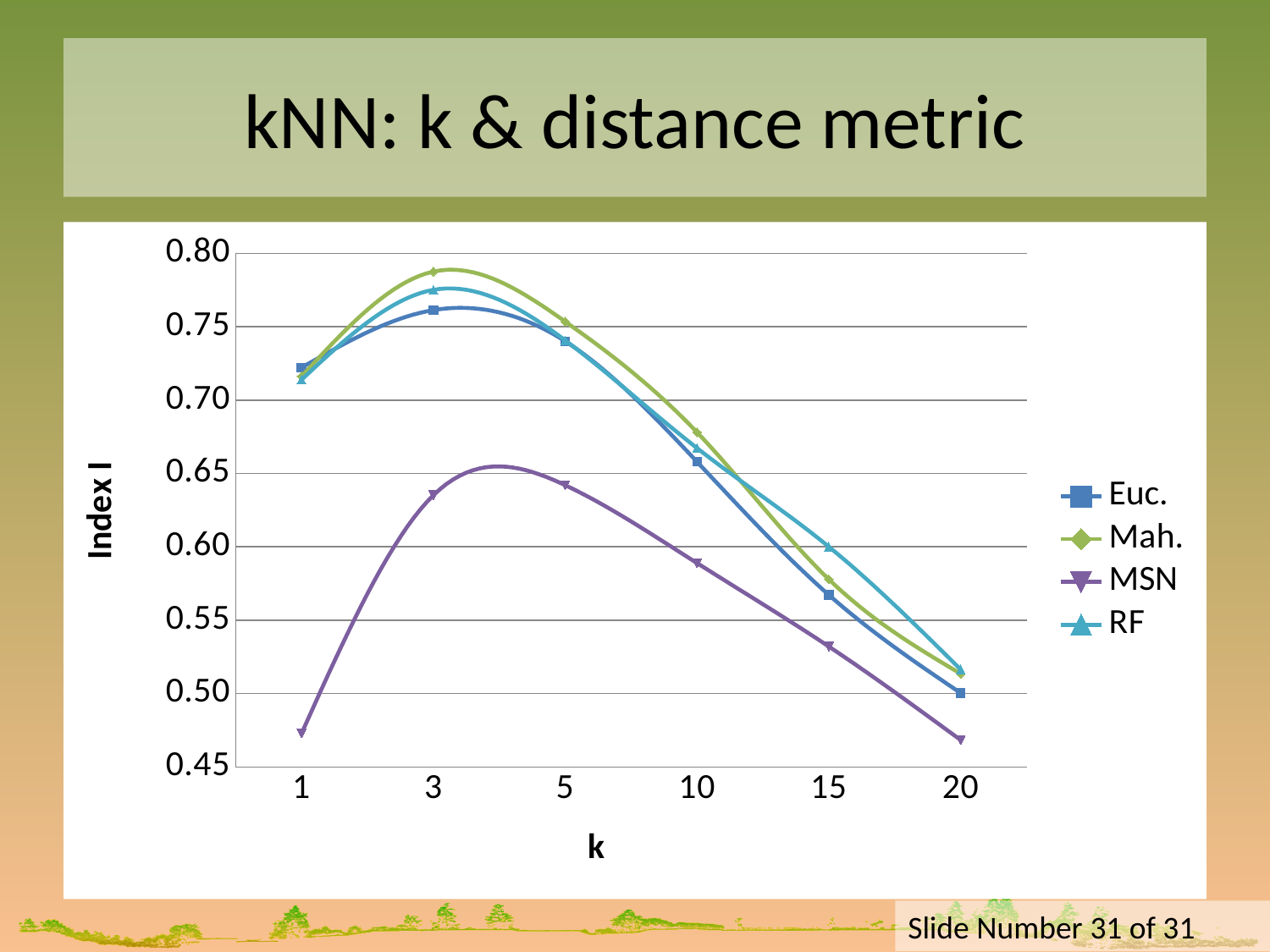
How many values of k are plotted along the x axis? 6 What kind of chart is shown on the slide? line chart At k = 15, which series has the larger Index I, RF or Euc.? RF Does the MSN series rise or fall from k = 5 to k = 20? fall Is the Index I value for MSN at k = 1 greater or less than 0.50? less How many series does the legend list? 4 Which series has the lowest Index I at k = 1? MSN Is the Index I value for Mah. at k = 3 greater or less than 0.75? greater Is the Index I value for Euc. at k = 20 greater or less than 0.55? less Which series has the highest Index I at k = 3? Mah. Which series has the lowest Index I at k = 20? MSN